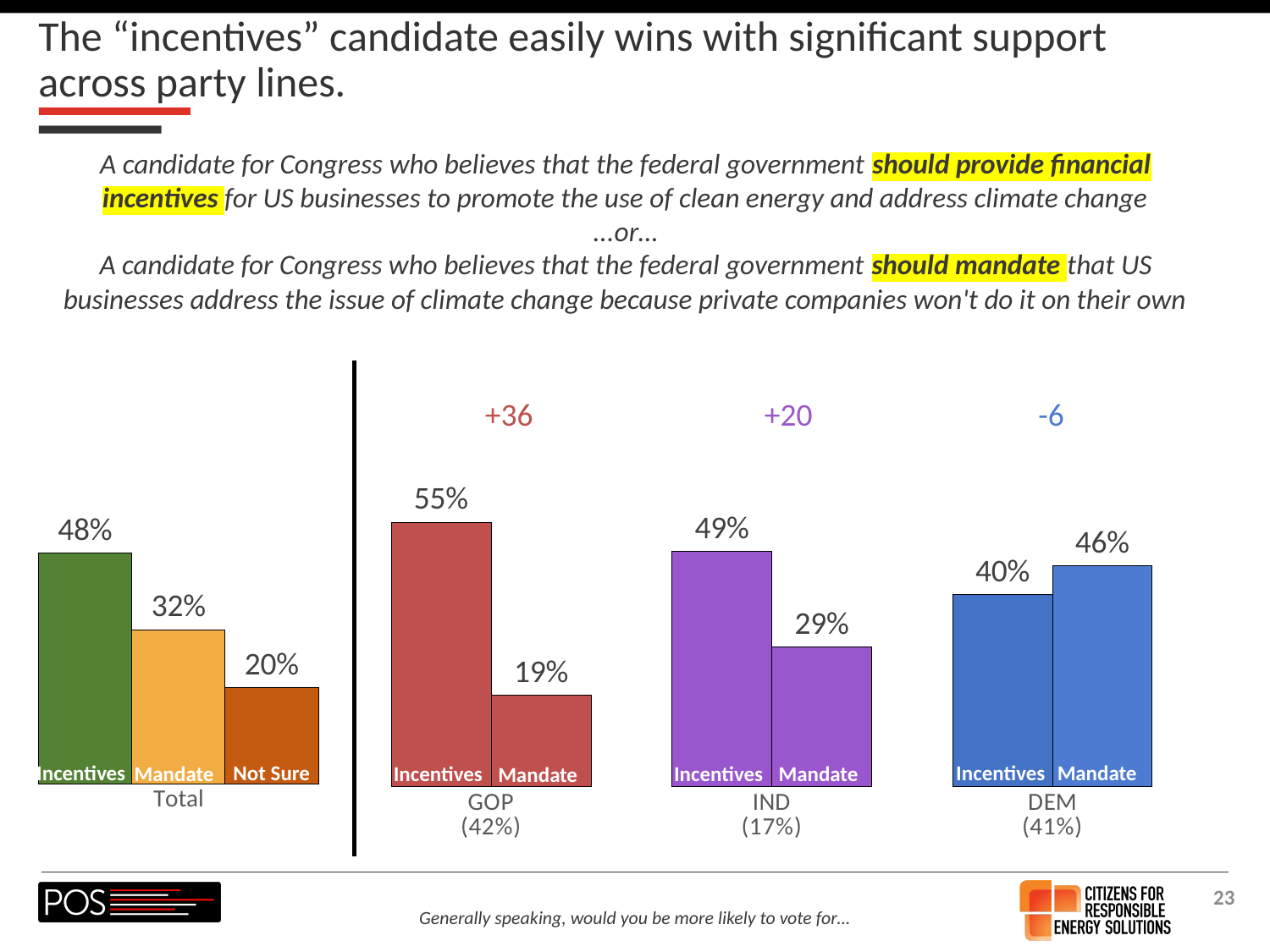
In the left chart (Total), what percentage chose Incentives? 48% In the right chart, what percentage of DEM respondents chose Mandate? 46% In the right chart, what percentage of IND respondents chose Incentives? 49% In the right chart, what is the difference between Incentives and Mandate for IND respondents? 20 percentage points In the right chart, which party group has the highest Incentives value? GOP In the right chart, for DEM respondents, which is larger: Incentives or Mandate? Mandate In the left chart (Total), which response has the lowest value? Not Sure What type of chart is used on this slide? Bar chart In the left chart (Total), what is the difference between Incentives and Mandate? 16 percentage points In the right chart, what percentage of GOP respondents chose Mandate? 19% In the left chart (Total), what percentage chose Not Sure? 20% How many party groups are shown in the right chart? 3